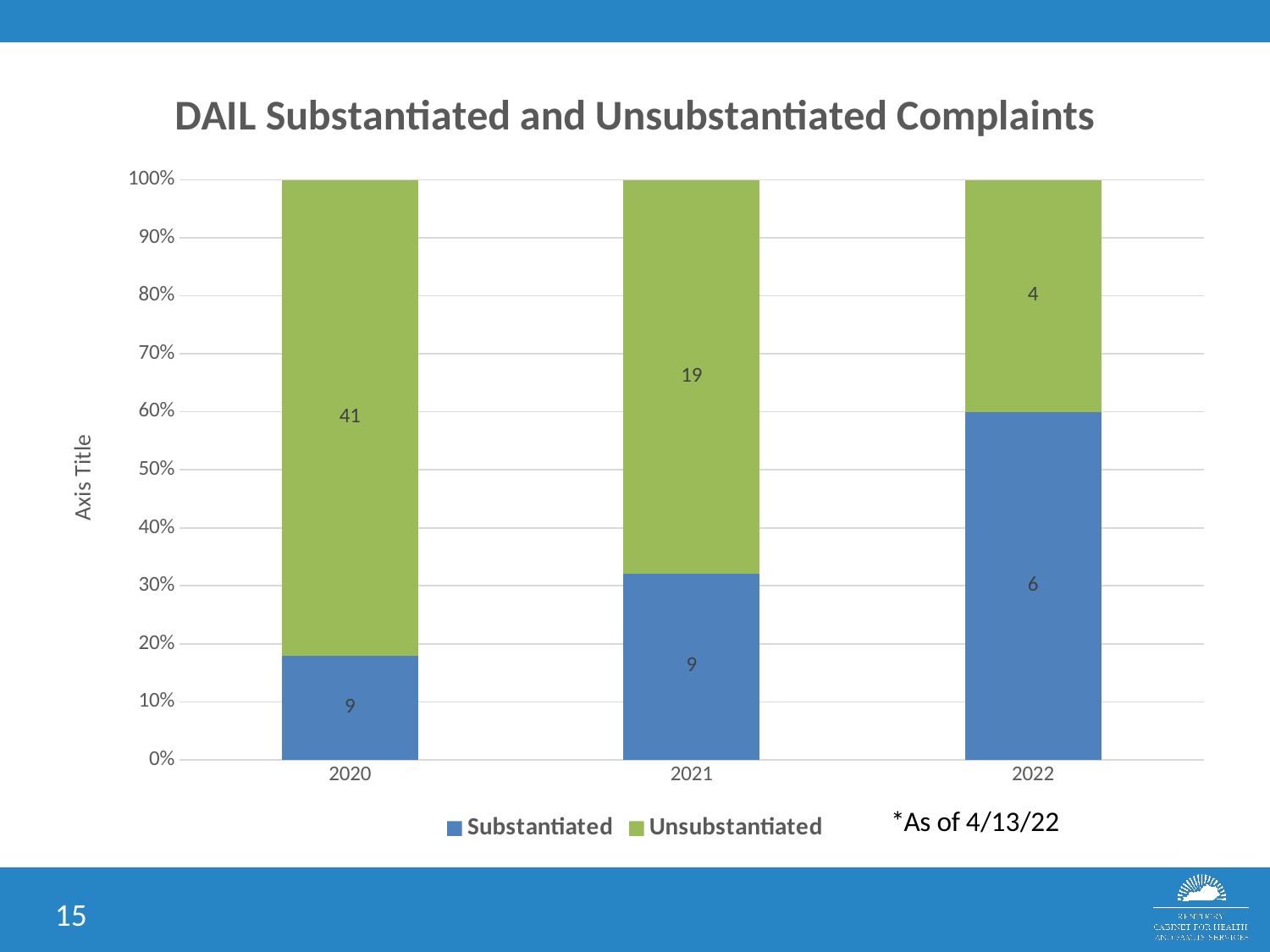
What is the Substantiated value for 2020? 9 Which year has the lowest Substantiated value? 2022 How many series does the legend list? 2 Which is larger for 2022, the Substantiated value or the Unsubstantiated value? Substantiated What is the title of the chart? DAIL Substantiated and Unsubstantiated Complaints What is the total of the Substantiated and Unsubstantiated values for 2020? 50 What is the Unsubstantiated value for 2022? 4 How many years are shown on the x axis? 3 What is the Substantiated value for 2022? 6 What is the Unsubstantiated value for 2021? 19 What is the difference between the Unsubstantiated values for 2020 and 2021? 22 Which year has the highest Unsubstantiated value? 2020